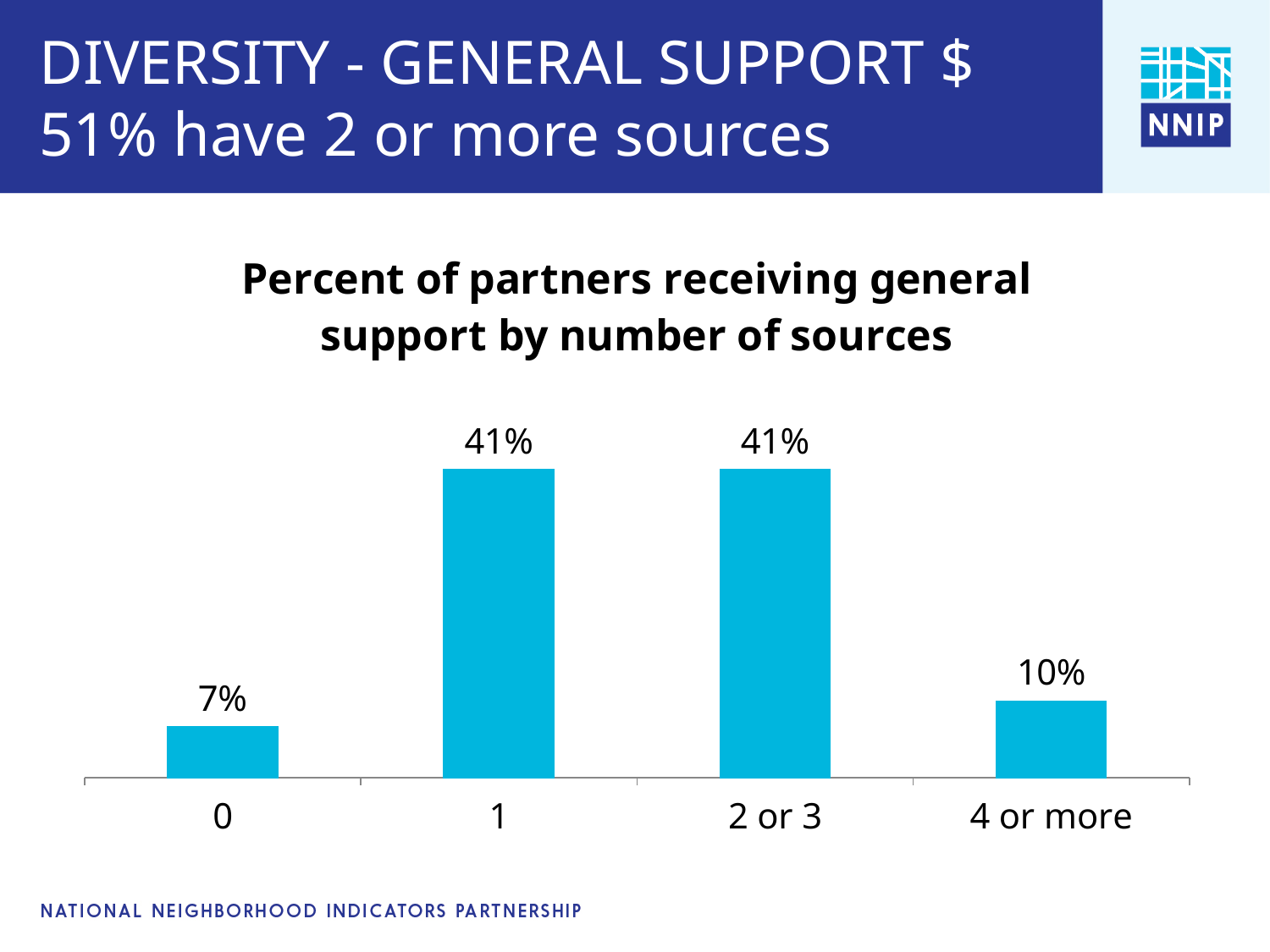
What is the difference between the value for 4 or more sources and the value for 0 sources? 3% What is the difference between the value for 1 source and the value for 4 or more sources? 31% What percent of partners receive general support from 0 sources? 7% How many categories are shown on the x axis? 4 Which is larger, the value for 1 source or the value for 4 or more sources? 1 What percent of partners receive general support from 2 or 3 sources? 41% Which is larger, the value for 4 or more sources or the value for 0 sources? 4 or more Which category has the lowest percent of partners? 0 What is the title of the chart? Percent of partners receiving general support by number of sources What kind of chart is shown on the slide? Bar chart What percent of partners receive general support from 1 source? 41% What percent of partners receive general support from 4 or more sources? 10%